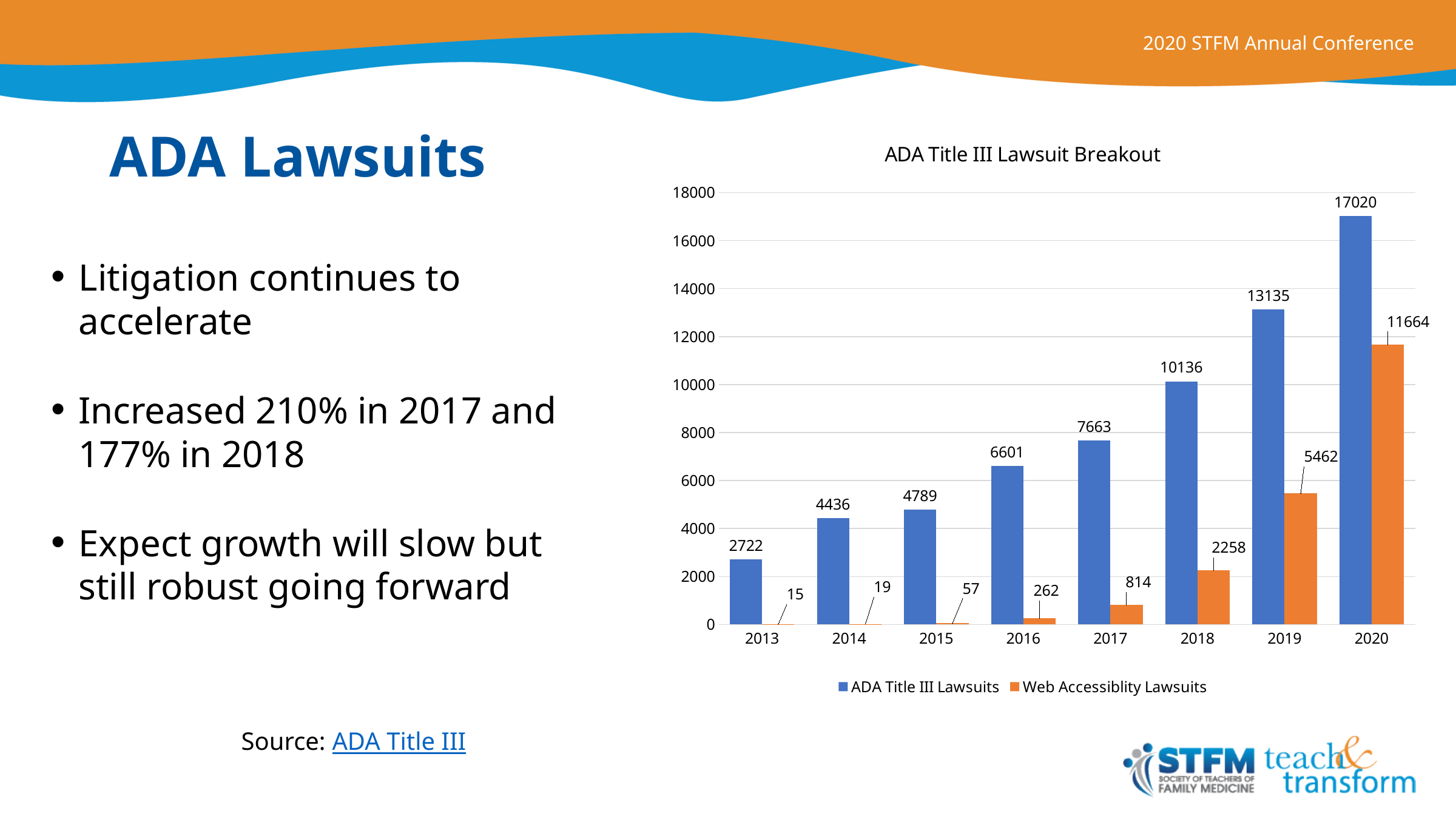
How many series does the legend list? 2 What is the title of the chart? ADA Title III Lawsuit Breakout Which year has the highest value for ADA Title III Lawsuits? 2020 Which is larger in 2018: ADA Title III Lawsuits or Web Accessiblity Lawsuits? ADA Title III Lawsuits What is the difference between ADA Title III Lawsuits and Web Accessiblity Lawsuits in 2020? 5356 What is the value for Web Accessiblity Lawsuits in 2019? 5462 Do the values for ADA Title III Lawsuits rise or fall from 2013 to 2020? Rise What kind of chart is shown on the slide? Bar chart Is the value for ADA Title III Lawsuits in 2019 greater or less than 12000? greater What is the value for ADA Title III Lawsuits in 2017? 7663 How many years are shown on the x axis? 8 Which year has the lowest value for Web Accessiblity Lawsuits? 2013